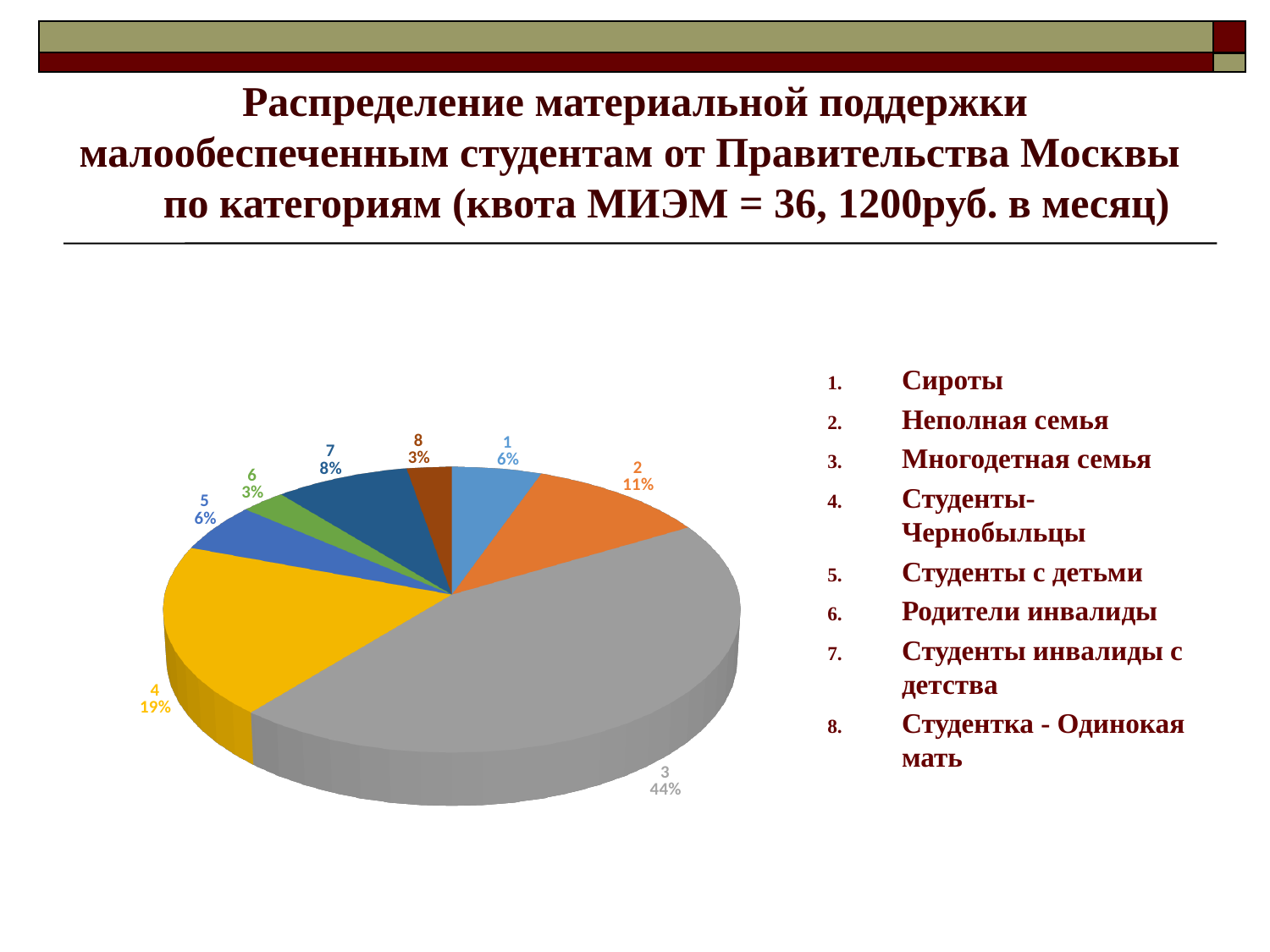
What percentage is shown for slice 1 (Сироты)? 6% What percentage is shown for slice 3 (Многодетная семья)? 44% How many slices does the pie chart have? 8 What percentage is shown for slice 2 (Неполная семья)? 11% What percentage is shown for slice 4 (Студенты-Чернобыльцы)? 19% Which category does the number 8 in the chart correspond to according to the legend? Студентка - Одинокая мать Which slice has the largest share of the pie? 3 (Многодетная семья) What percentage is shown for slice 7 (Студенты инвалиды с детства)? 8% Which slice is larger, slice 2 or slice 7? slice 2 What is the difference in percentage points between slice 4 and slice 2? 8 What is the difference in percentage points between slice 3 and slice 4? 25 What type of chart is shown on the slide? pie chart